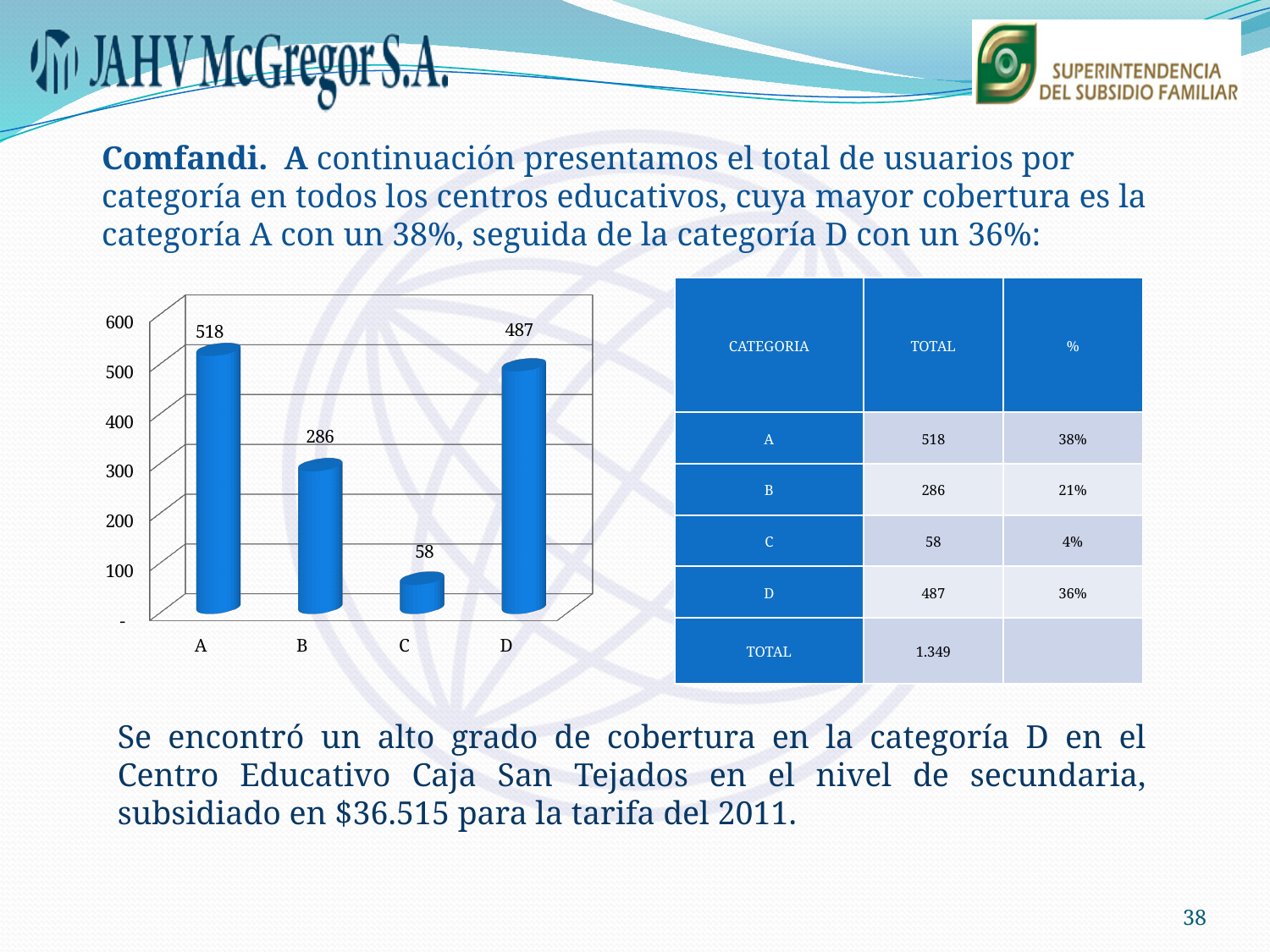
What is the value for category C in the bar chart? 58 What is the difference between the values for category B and category C in the bar chart? 228 What is the value for category D in the bar chart? 487 What is the total of the four category values shown in the bar chart? 1.349 Which is larger in the bar chart, the value for category B or the value for category D? D Which category has the highest value in the bar chart? A How many categories are shown in the bar chart? 4 What is the value for category B in the bar chart? 286 What kind of chart is shown on the slide? Bar chart Which category has the lowest value in the bar chart? C What is the value for category A in the bar chart? 518 What is the difference between the values for category A and category D in the bar chart? 31